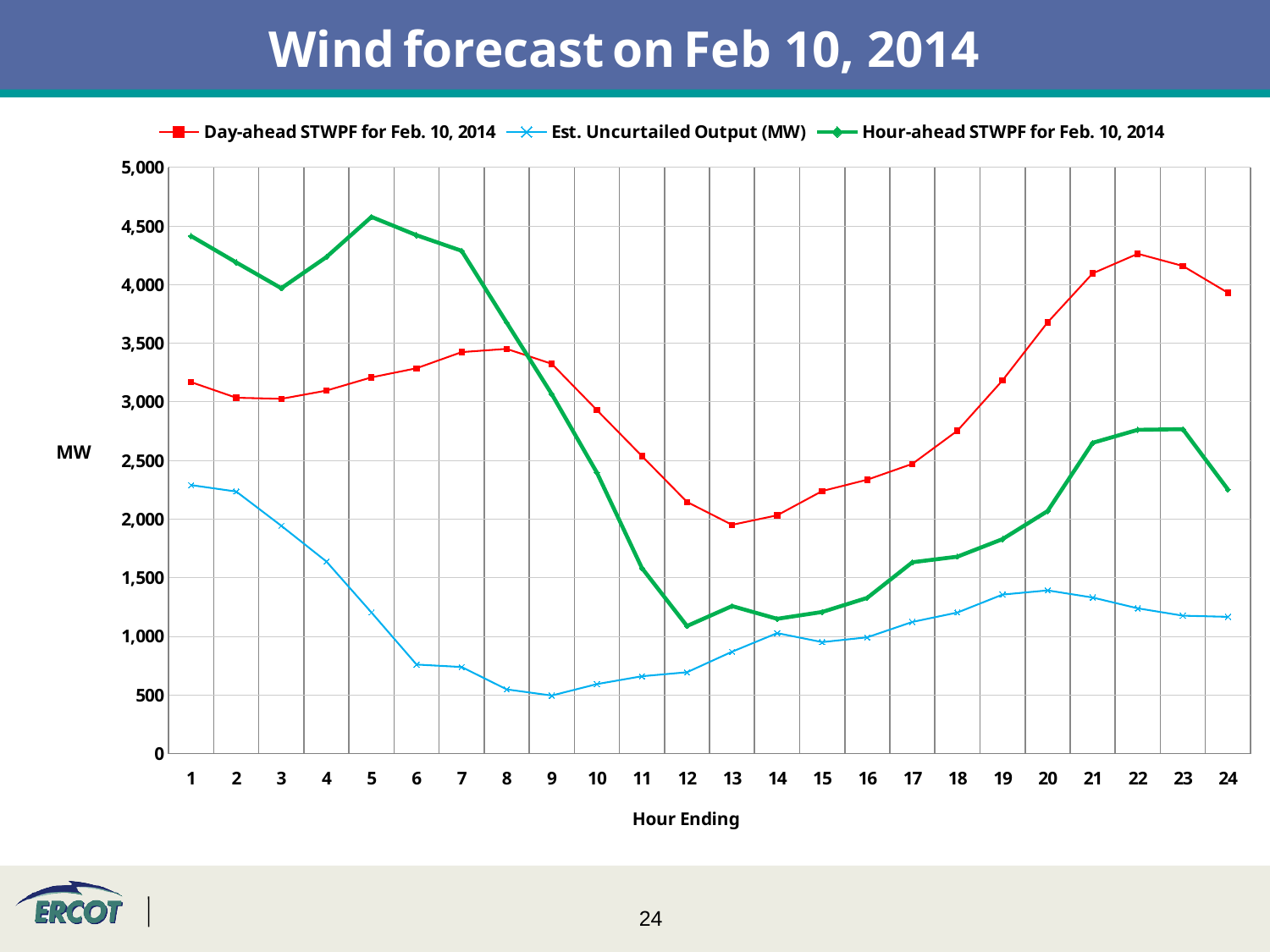
Is the Est. Uncurtailed Output value at hour ending 6 greater or less than 1,000? less At which hour ending does the Day-ahead STWPF for Feb. 10, 2014 series reach its highest value? 22 Is the Hour-ahead STWPF value at hour ending 12 greater or less than 1,500? less At which hour ending does the Hour-ahead STWPF for Feb. 10, 2014 series reach its highest value? 5 How many series does the legend list? 3 Is the Day-ahead STWPF value at hour ending 1 greater or less than 3,000? greater How many hours are plotted along the x axis? 24 At hour ending 20, which is higher: the Day-ahead STWPF or the Hour-ahead STWPF? Day-ahead STWPF for Feb. 10, 2014 What kind of chart is shown on the slide? line chart Does the Est. Uncurtailed Output (MW) series rise or fall from hour ending 1 to hour ending 9? fall At which hour ending does the Est. Uncurtailed Output (MW) series reach its lowest value? 9 At hour ending 1, which is higher: the Day-ahead STWPF or the Hour-ahead STWPF? Hour-ahead STWPF for Feb. 10, 2014